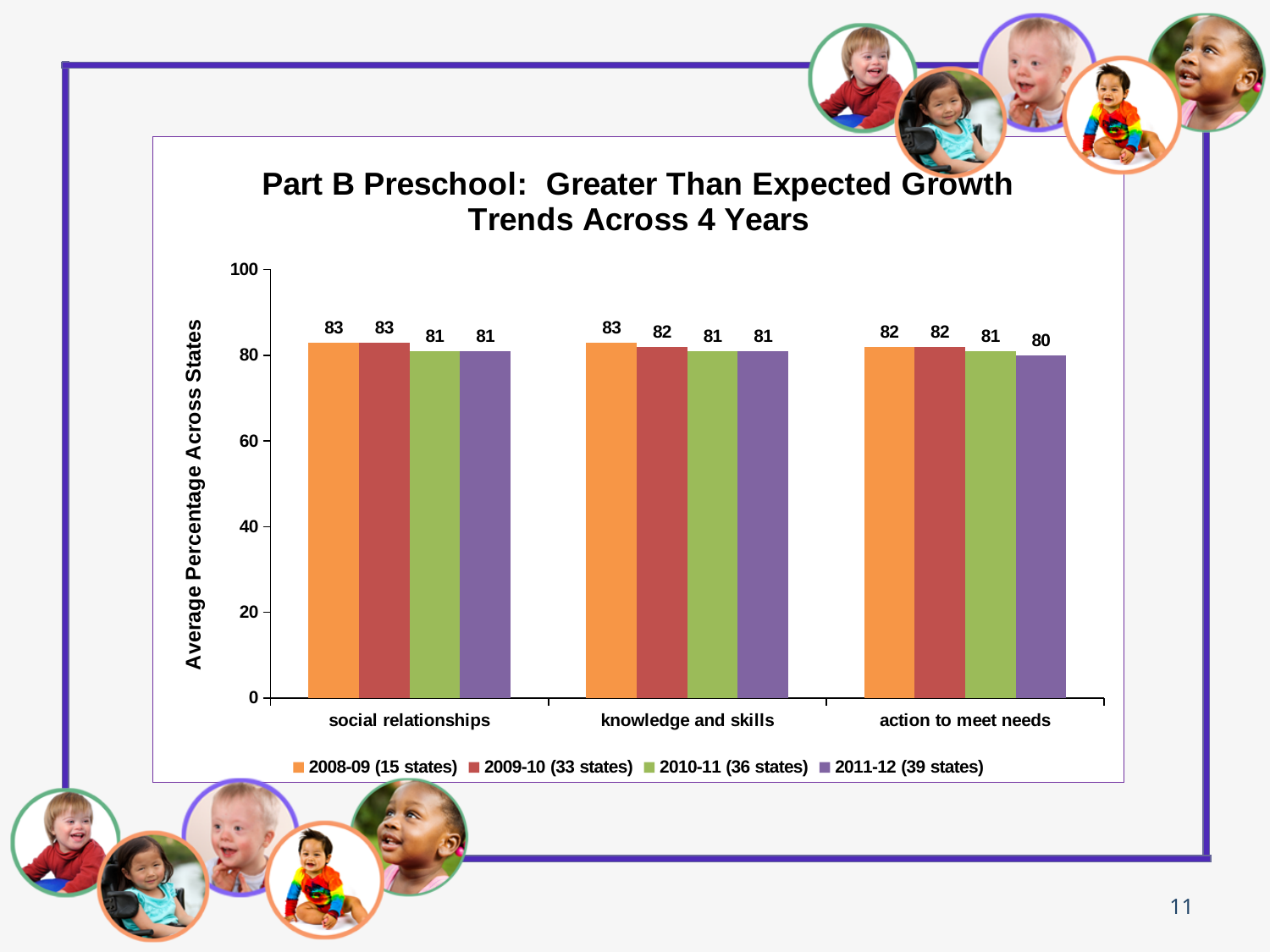
Which category has the lowest value in the 2011-12 (39 states) series? action to meet needs What is the value for action to meet needs in the 2010-11 (36 states) series? 81 What is the value for knowledge and skills in the 2009-10 (33 states) series? 82 How many series does the legend list? 4 What is the label of the y axis? Average Percentage Across States What kind of chart is shown on the slide? bar chart What is the difference between the 2008-09 (15 states) and 2011-12 (39 states) values for knowledge and skills? 2 Is the value for social relationships in the 2010-11 (36 states) series greater or less than 80? greater What is the value for social relationships in the 2008-09 (15 states) series? 83 What is the value for action to meet needs in the 2011-12 (39 states) series? 80 What is the difference between the 2008-09 (15 states) and 2011-12 (39 states) values for action to meet needs? 2 How many categories are shown on the x axis? 3